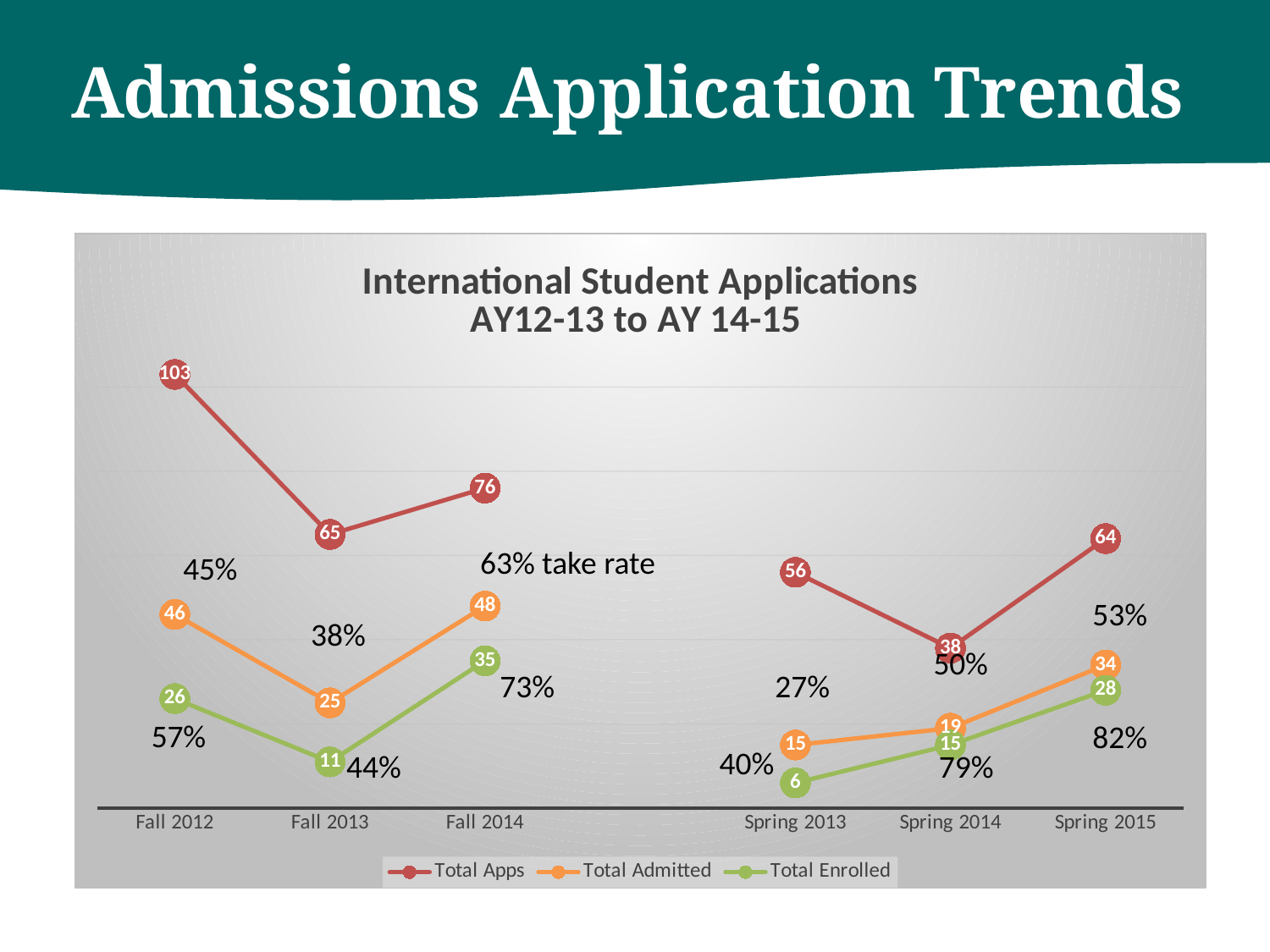
What is the difference between Total Apps and Total Admitted in Spring 2015? 30 Which category has the lowest Total Enrolled value? Spring 2013 How many labeled categories are on the x axis? 6 How many series does the legend list? 3 Which is larger, Total Admitted in Fall 2012 or Total Admitted in Fall 2014? Fall 2014 What is the Total Enrolled value for Spring 2013? 6 Does Total Apps rise or fall from Fall 2012 to Fall 2013? fall What is the Total Apps value for Fall 2012? 103 What is the title of the chart? International Student Applications AY12-13 to AY 14-15 Which category has the highest Total Apps value? Fall 2012 What is the Total Admitted value for Fall 2014? 48 What type of chart is shown on the slide? line chart